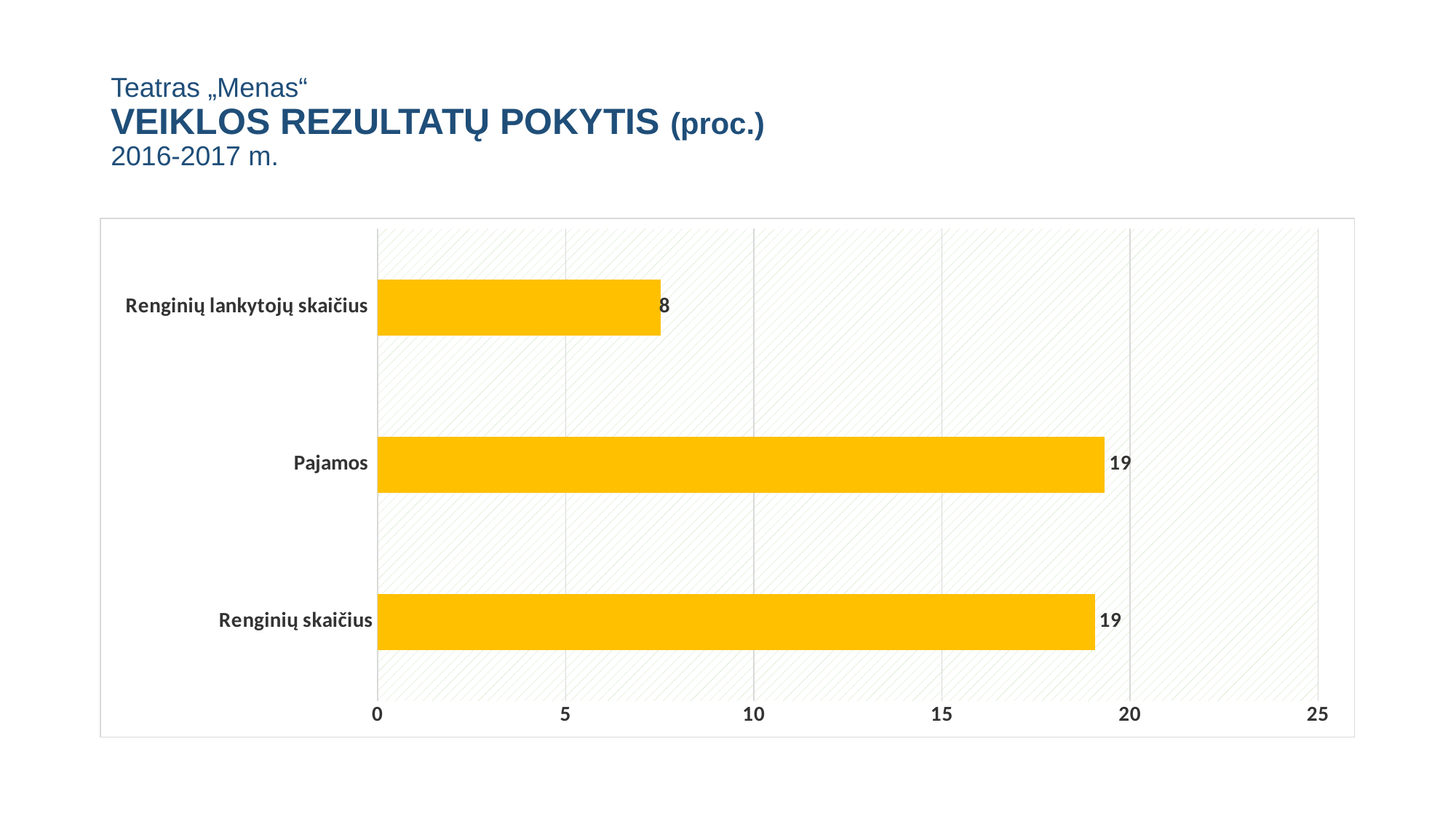
What is the value for Pajamos? 19 Is the value for Renginių lankytojų skaičius greater or less than 10? less Is the value for Pajamos greater or less than 15? greater How many categories are shown in the chart? 3 What is the difference between the values for Renginių skaičius and Renginių lankytojų skaičius? 11 Which is larger, the value for Pajamos or the value for Renginių lankytojų skaičius? Pajamos What kind of chart is shown on the slide? bar chart Which category has the lowest value? Renginių lankytojų skaičius What is the value for Renginių lankytojų skaičius? 8 What is the difference between the values for Pajamos and Renginių lankytojų skaičius? 11 What is the value for Renginių skaičius? 19 What colour are the bars in the chart? yellow